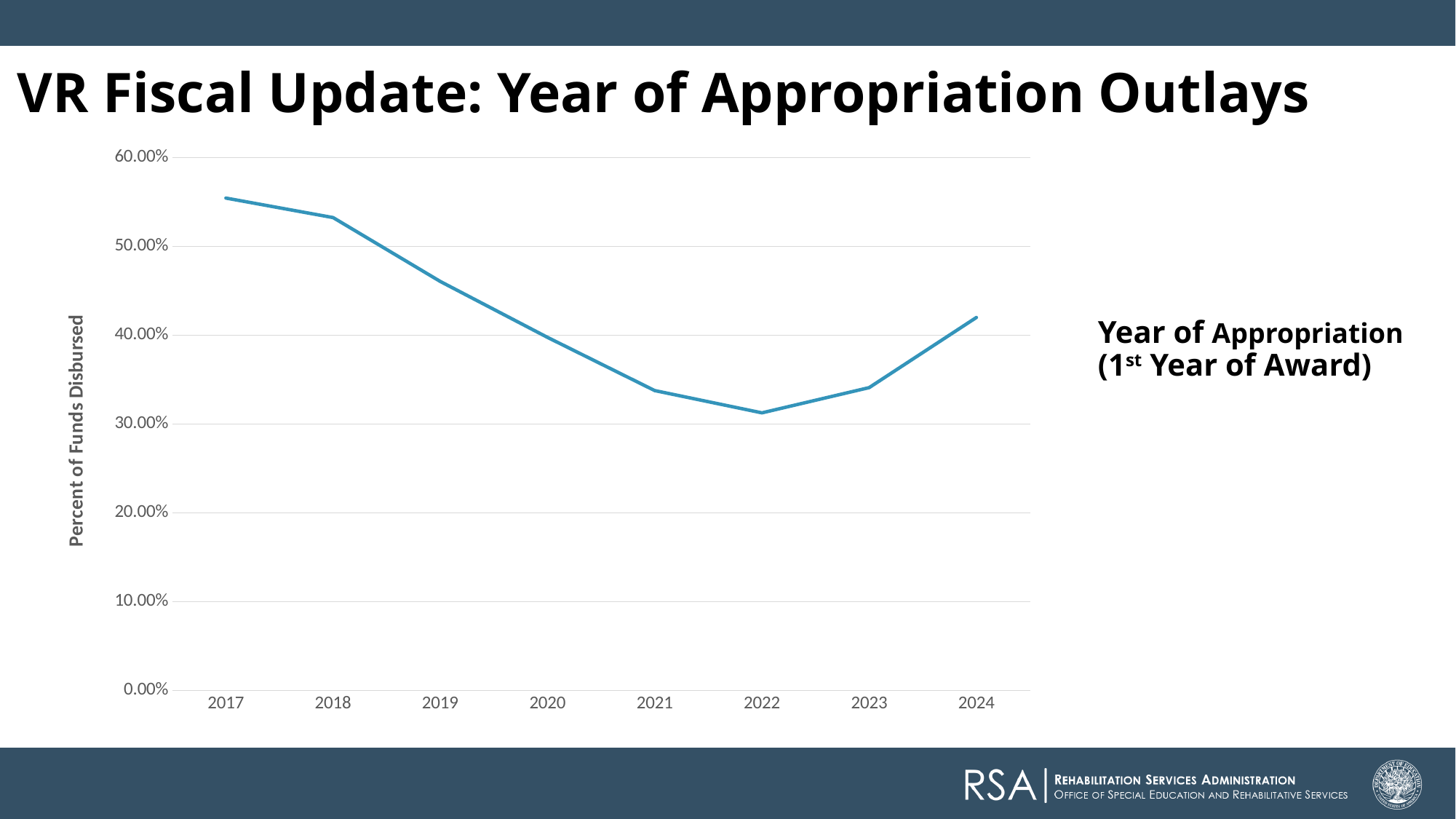
What is the first year shown on the x axis? 2017 Which year has a higher percent of funds disbursed, 2019 or 2023? 2019 What is the title of the y axis? Percent of Funds Disbursed Which year has the highest percent of funds disbursed? 2017 Which year has the lowest percent of funds disbursed? 2022 Is the value for 2022 greater or less than 30.00%? greater Do the values rise or fall from 2017 to 2022? fall Is the value for 2017 greater or less than 50.00%? greater How many years are plotted along the x axis of the chart? 8 Is the value for 2024 greater or less than 40.00%? greater What kind of chart is shown on the slide? line chart